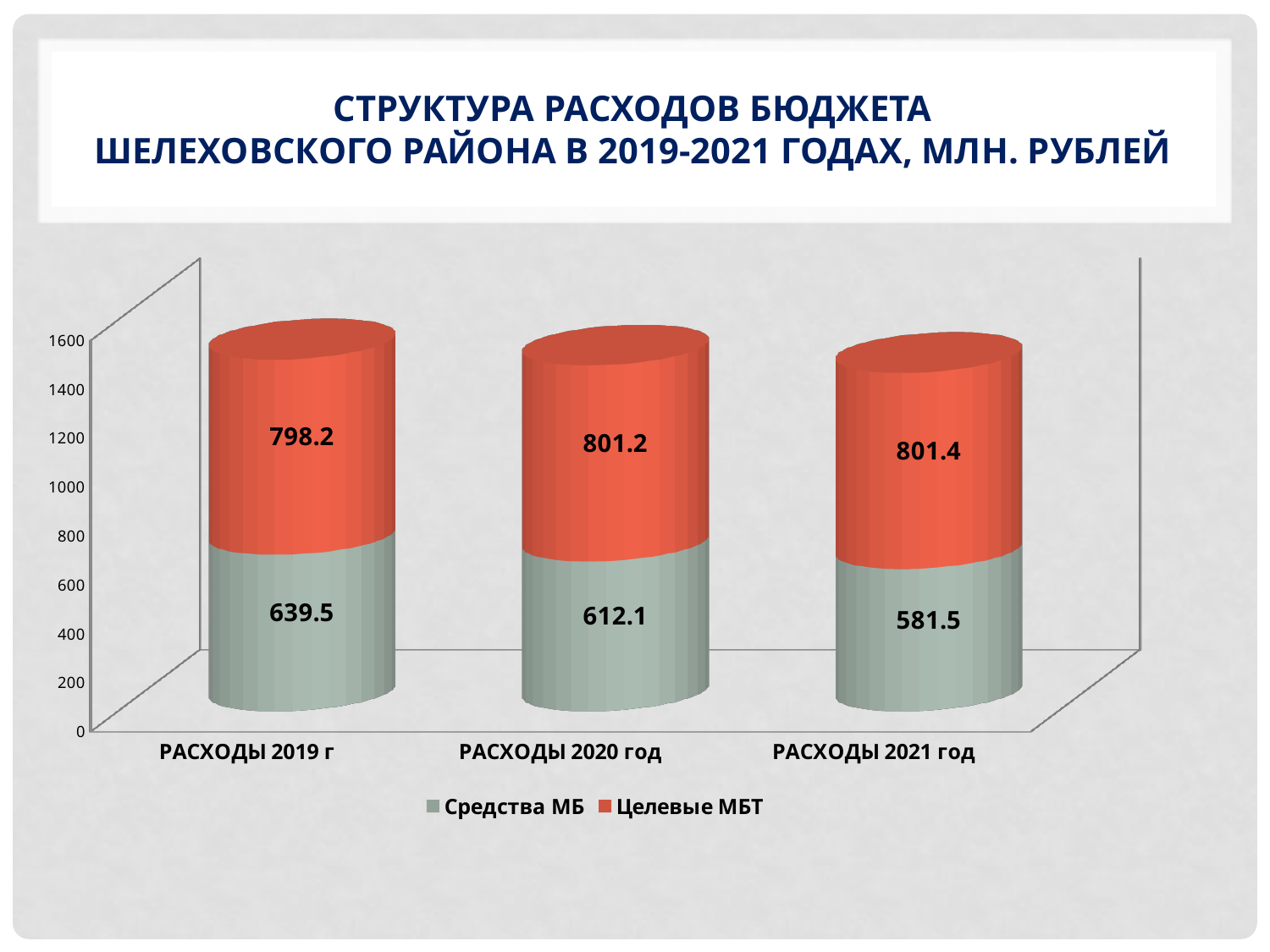
In which year is the Средства МБ value the highest? РАСХОДЫ 2019 г What kind of chart is shown on the slide? Stacked bar chart What is the difference between the Средства МБ values for РАСХОДЫ 2019 г and РАСХОДЫ 2021 год? 58.0 What is the total of the stacked bar for РАСХОДЫ 2020 год? 1413.3 What is the value of Средства МБ for РАСХОДЫ 2020 год? 612.1 How many series does the legend list? 2 In which year is the Средства МБ value the lowest? РАСХОДЫ 2021 год Do the Средства МБ values rise or fall from 2019 to 2021? Fall How many categories are shown on the x axis? 3 What is the value of Средства МБ for РАСХОДЫ 2019 г? 639.5 Which is larger: Целевые МБТ for РАСХОДЫ 2019 г or Средства МБ for РАСХОДЫ 2019 г? Целевые МБТ What is the value of Целевые МБТ for РАСХОДЫ 2021 год? 801.4